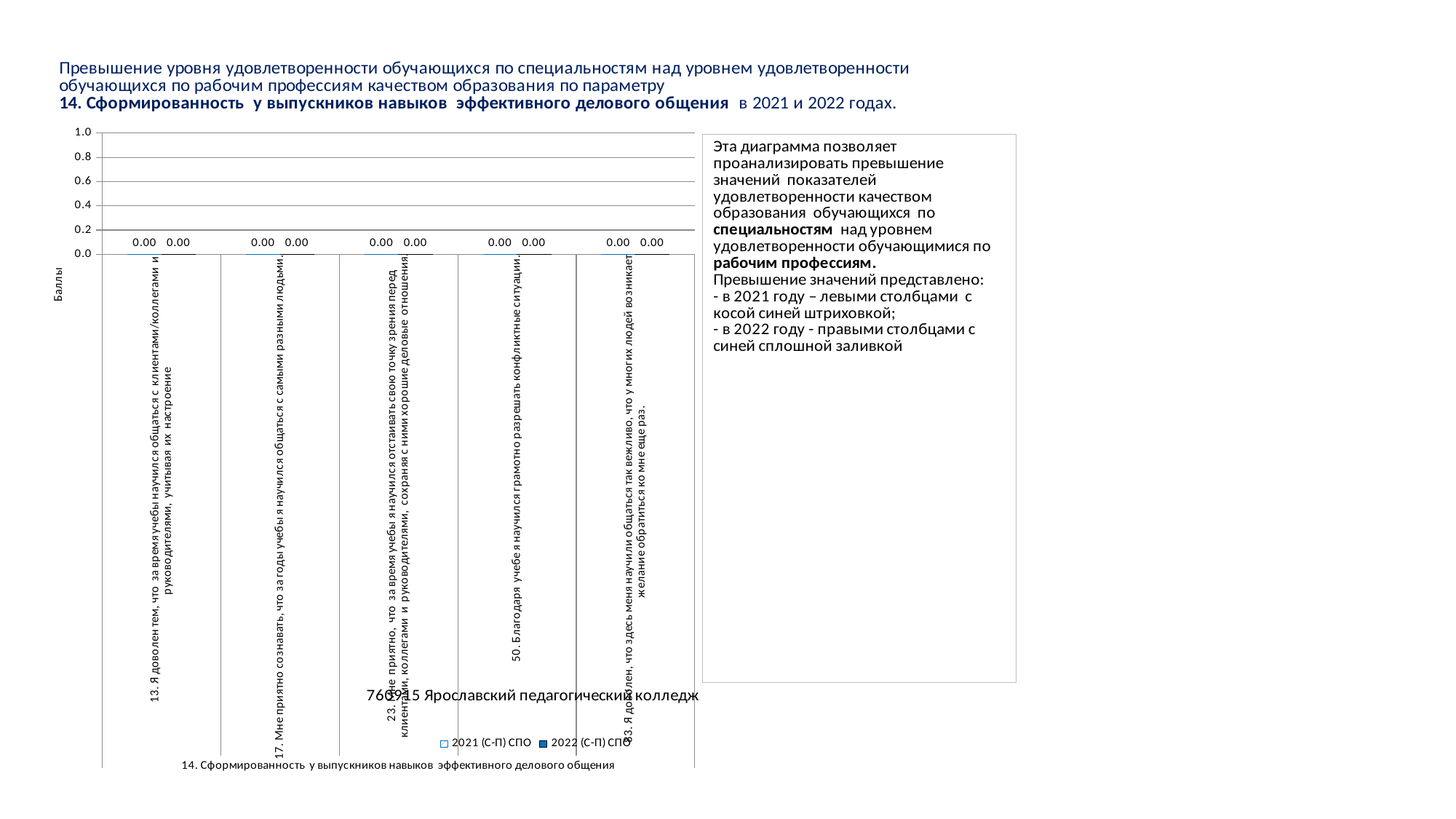
What is the difference between the 2021 (С-П) СПО and 2022 (С-П) СПО values for statement 23? 0.00 Is the value of the 2022 (С-П) СПО series for statement 13 greater or less than 0.2? less What is the value of the 2022 (С-П) СПО series for statement 50 ("Благодаря учебе я научился грамотно разрешать конфликтные ситуации")? 0.00 What is the value of the 2021 (С-П) СПО series for statement 13 ("Я доволен тем, что за время учебы научился общаться с клиентами/коллегами и руководителями, учитывая их настроение")? 0.00 What kind of chart is shown on the slide? Bar chart What is the value of the 2021 (С-П) СПО series for statement 17 ("Мне приятно сознавать, что за годы учебы я научился общаться с самыми разными людьми")? 0.00 How many categories (statements) are plotted along the x axis of the chart? 5 What is the label of the vertical axis of the chart? Баллы What are the two series names listed in the chart legend? 2021 (С-П) СПО and 2022 (С-П) СПО How many series does the chart legend list? 2